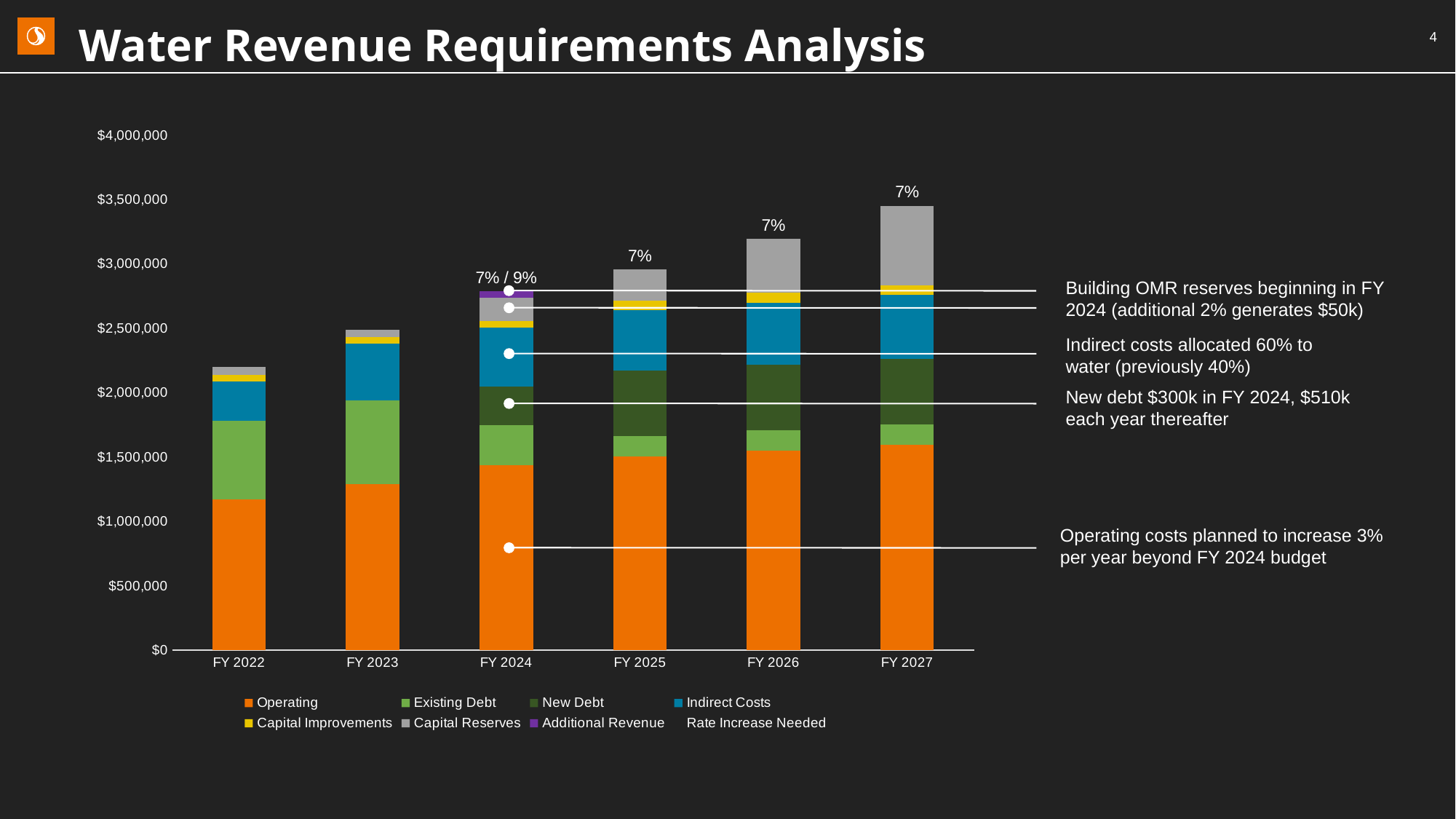
Do the total bar heights rise or fall from FY 2022 to FY 2027? Rise How many entries does the chart's legend list? 8 Which fiscal year has the tallest stacked bar? FY 2027 Is the Operating segment for FY 2022 greater or less than $1,000,000? greater What rate increase label is shown above the FY 2026 bar? 7% Is the total for FY 2022 greater or less than $2,500,000? less What kind of chart is shown on the slide? Stacked bar chart What rate increase label is shown above the FY 2024 bar? 7% / 9% Which legend entry is shown in purple? Additional Revenue Which fiscal year has the shortest stacked bar? FY 2022 Is the total for FY 2027 greater or less than $3,000,000? greater How many fiscal years are shown on the x axis of the chart? 6